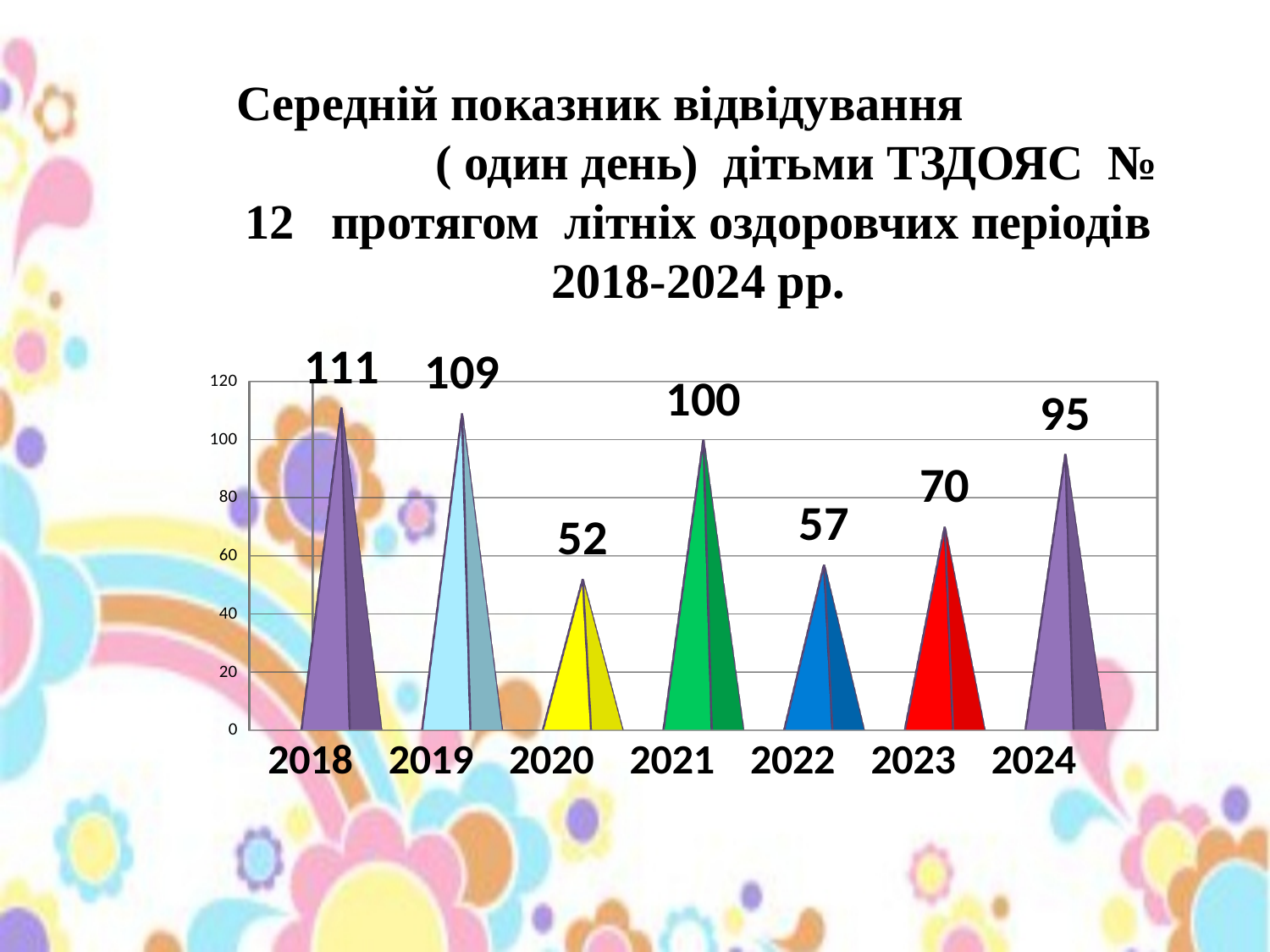
Which year has the highest value? 2018 What is the difference between the values for 2021 and 2022? 43 Do the values rise or fall from 2018 to 2020? fall What kind of chart is this? bar chart What is the value for 2020? 52 What is the value for 2024? 95 What is the difference between the values for 2018 and 2019? 2 Which is larger, the value for 2023 or the value for 2024? 2024 How many years are shown on the x axis? 7 What is the value for 2023? 70 Which year has the lowest value? 2020 What is the value for 2018? 111